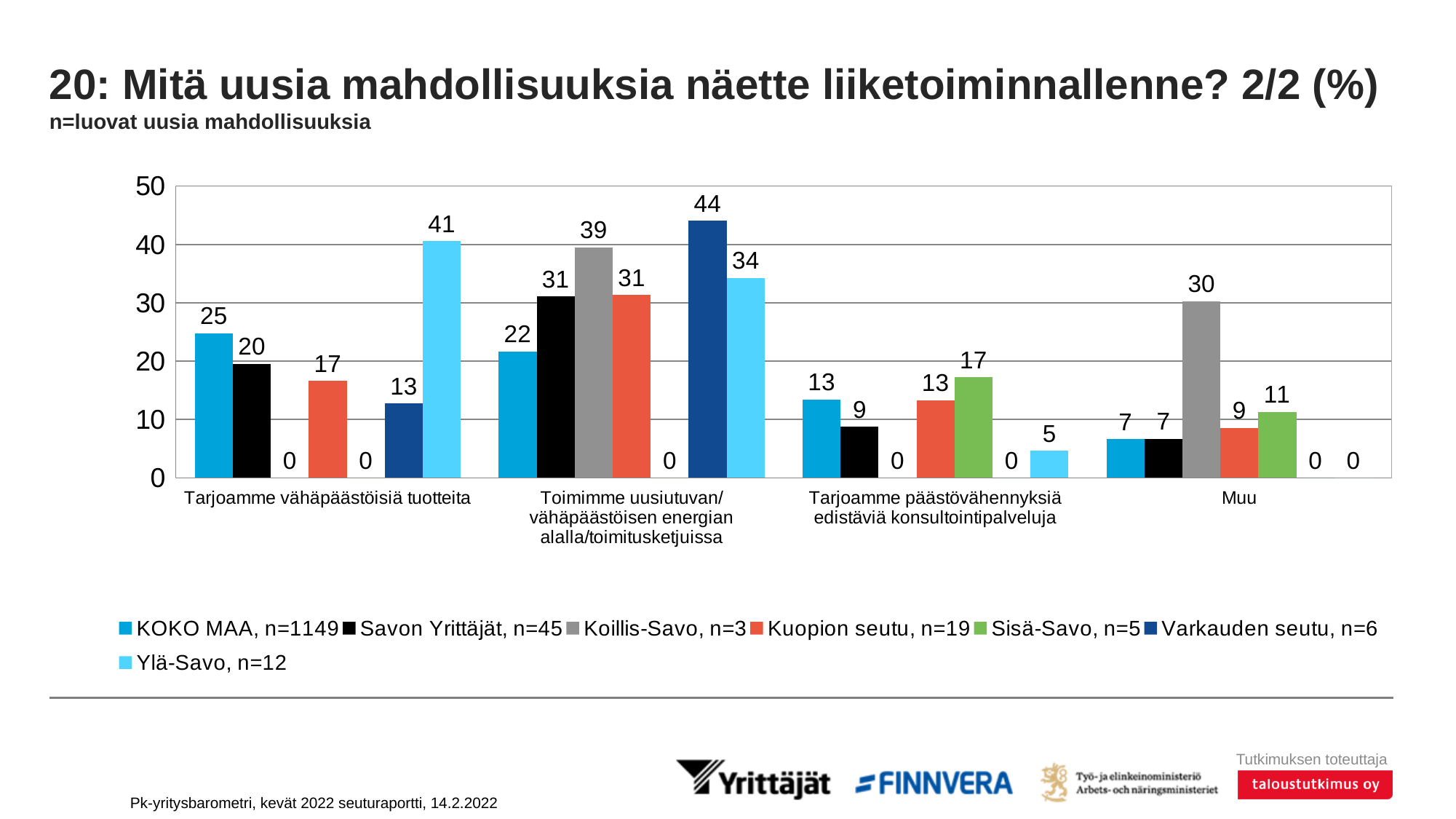
Which series has the highest value in the category "Tarjoamme päästövähennyksiä edistäviä konsultointipalveluja"? Sisä-Savo, n=5 How many categories are shown on the x axis? 4 What is the value for Ylä-Savo in the category "Tarjoamme vähäpäästöisiä tuotteita"? 41 What is the value for Koillis-Savo in the category "Muu"? 30 Which category has the lowest value for KOKO MAA? Muu How many series does the legend list? 7 What is the value for Varkauden seutu in the category "Toimimme uusiutuvan/vähäpäästöisen energian alalla/toimitusketjuissa"? 44 What is the difference between the KOKO MAA value and the Savon Yrittäjät value in the category "Tarjoamme vähäpäästöisiä tuotteita"? 5 What type of chart is shown on the slide? bar chart Is the value for Varkauden seutu in the category "Toimimme uusiutuvan/vähäpäästöisen energian alalla/toimitusketjuissa" greater or less than 40? greater In the category "Toimimme uusiutuvan/vähäpäästöisen energian alalla/toimitusketjuissa", which is larger: the value for Koillis-Savo or the value for Ylä-Savo? Koillis-Savo What is the sample size (n) shown in the legend for Kuopion seutu? n=19